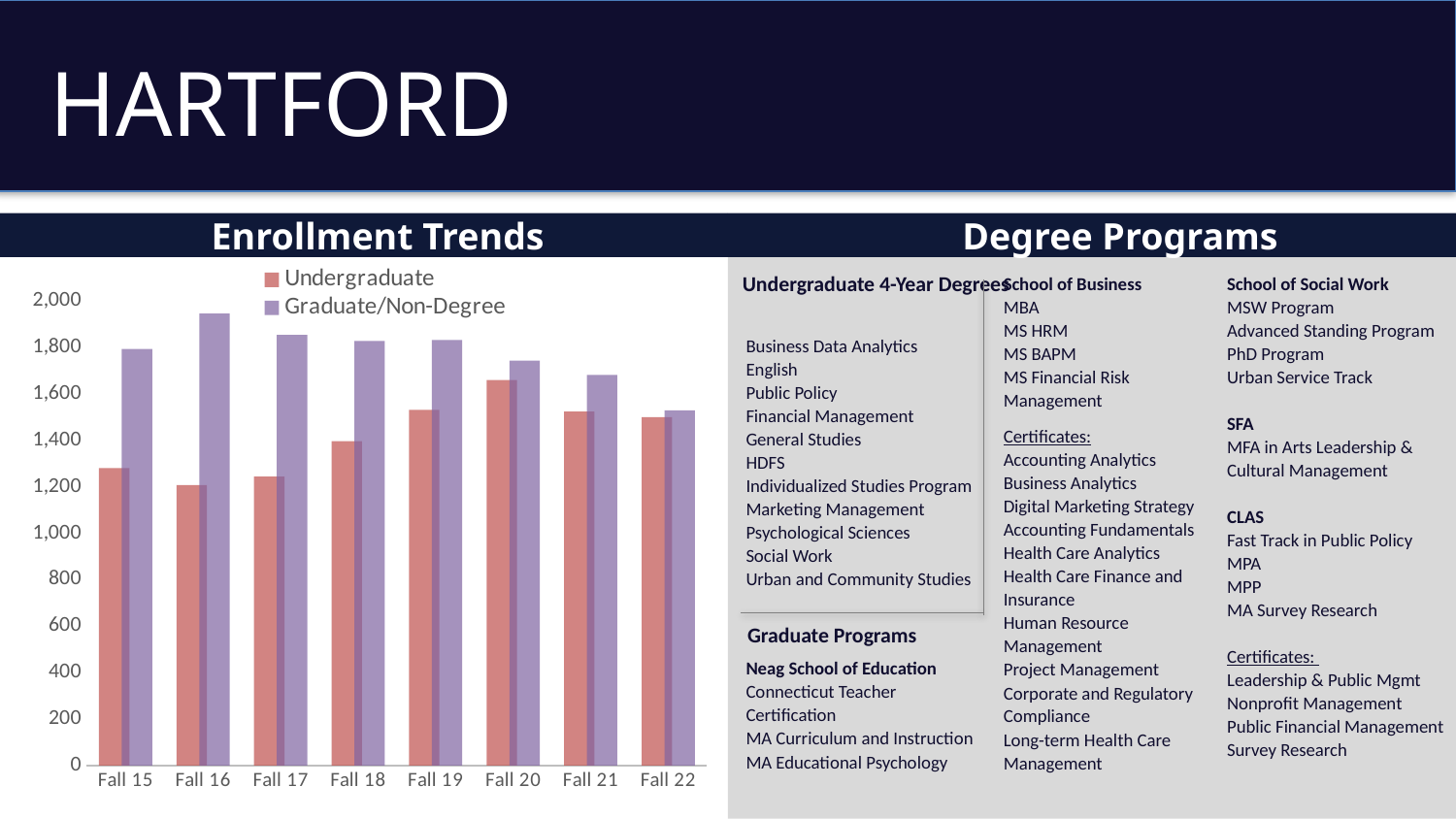
Does Graduate/Non-Degree enrollment rise or fall from Fall 19 to Fall 22? fall What kind of chart is shown under Enrollment Trends? bar chart How many semesters are shown on the x axis of the Enrollment Trends chart? 8 How many series does the legend of the Enrollment Trends chart list? 2 In which semester is Graduate/Non-Degree enrollment lowest? Fall 22 Is the Undergraduate value for Fall 15 greater or less than 1,400? less Is the Graduate/Non-Degree value for Fall 16 greater or less than 1,800? greater Which colour represents the Undergraduate series in the Enrollment Trends chart? red/salmon Which is larger in Fall 20, Undergraduate or Graduate/Non-Degree enrollment? Graduate/Non-Degree In which semester is Undergraduate enrollment lowest? Fall 16 In which semester is Undergraduate enrollment highest? Fall 20 In which semester is Graduate/Non-Degree enrollment highest? Fall 16